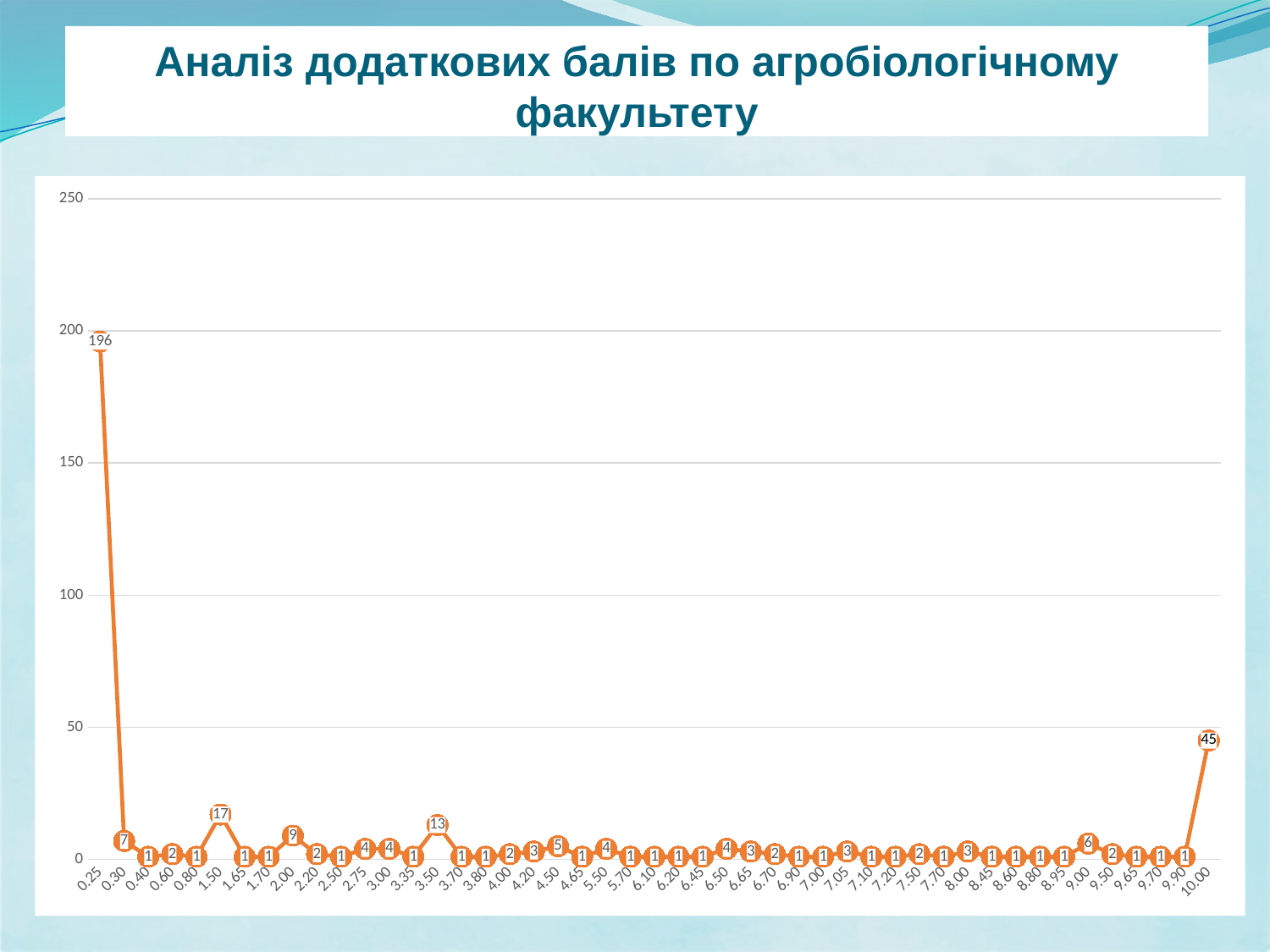
Which has the larger value, 1.50 or 3.50? 1.50 What kind of chart is shown on the slide? line chart What is the value for 9.00? 6 What is the value for 0.25? 196 What is the difference between the values for 0.25 and 10.00? 151 What is the value for 10.00? 45 Is the value for 0.25 greater or less than 150? greater What is the title of the slide? Аналіз додаткових балів по агробіологічному факультету What is the value for 1.50? 17 What is the value for 3.50? 13 What is the value for 2.00? 9 Which category has the highest value? 0.25